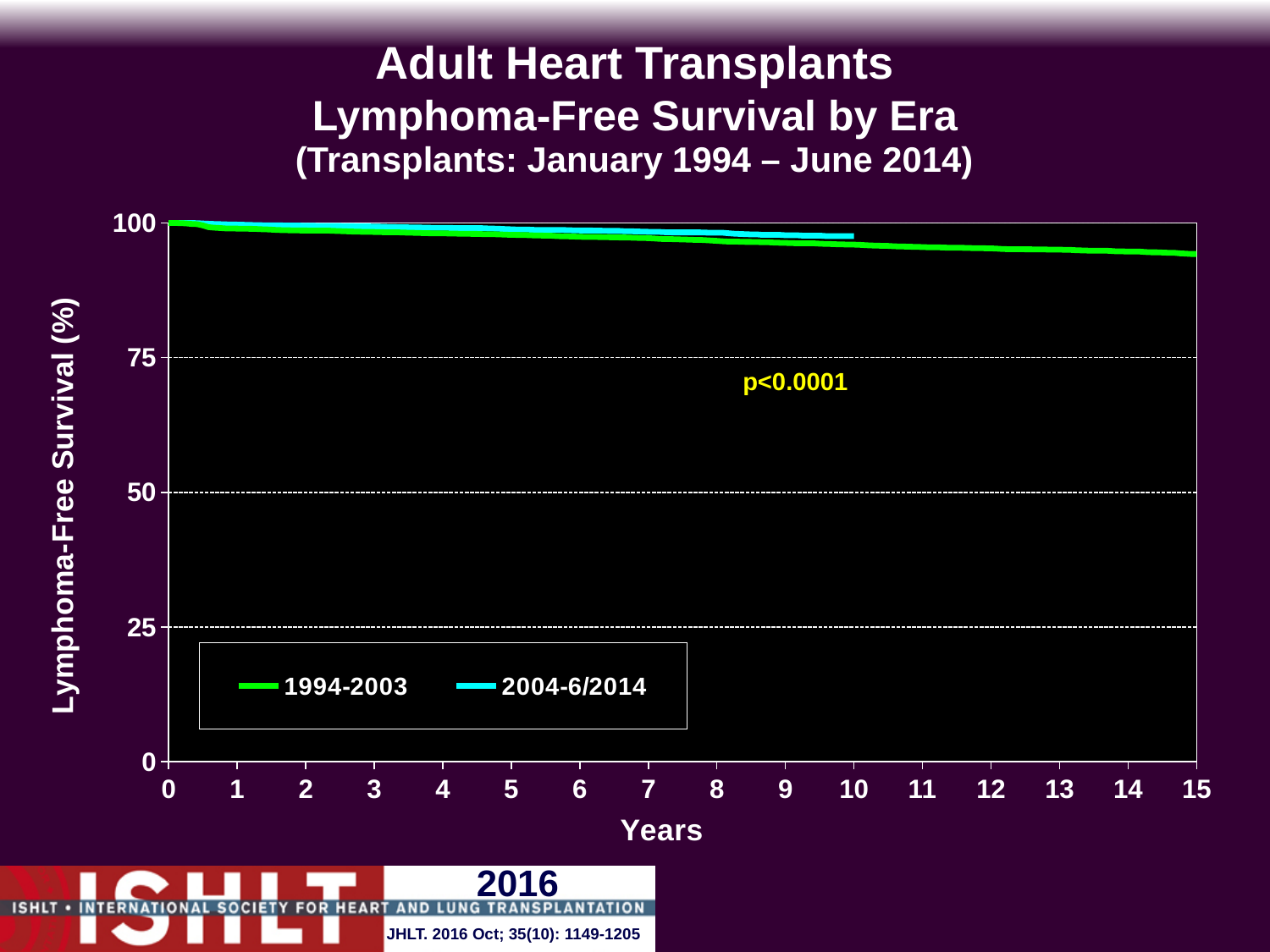
What is the highest value shown on the Years axis? 15 What p-value is printed on the chart? p<0.0001 How many series does the legend list? 2 Is the lymphoma-free survival for the 2004-6/2014 era at 10 years greater or less than 75? greater What is the label of the y axis? Lymphoma-Free Survival (%) Which era's curve extends further along the Years axis? 1994-2003 Is the lymphoma-free survival for the 1994-2003 era at 10 years greater or less than 50? greater Do the lymphoma-free survival curves rise or fall as years increase? fall What kind of chart is shown on the slide? line chart Is the lymphoma-free survival for the 1994-2003 era at 15 years greater or less than 75? greater